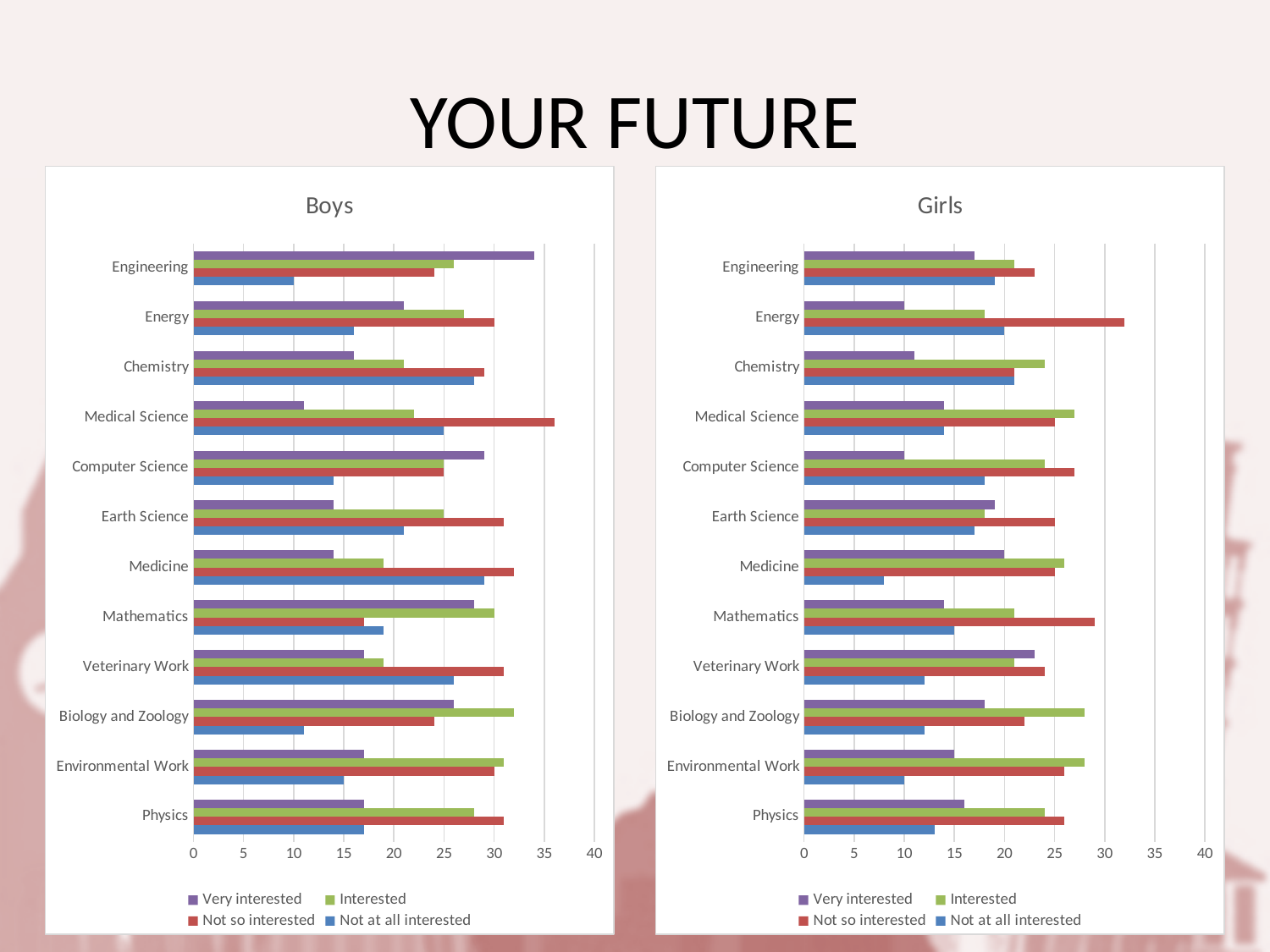
In the Girls chart, is the Not at all interested value for Medicine greater or less than 10? less How many series does the legend of the Girls chart list? 4 In the Boys chart, which subject has the highest Very interested value? Engineering In the Girls chart, is the Not so interested value for Energy greater or less than 30? greater In the Boys chart, which subject has the highest Not so interested value? Medical Science In the Boys chart, is the Very interested value for Engineering greater or less than 30? greater What kind of chart is the Boys chart? bar chart How many subject categories are shown on the Boys chart? 12 In the Girls chart, which subject has the highest Very interested value? Veterinary Work Which is larger: the Very interested value for Engineering in the Boys chart or in the Girls chart? Boys What are the four legend entries on the Boys chart? Very interested, Interested, Not so interested, Not at all interested